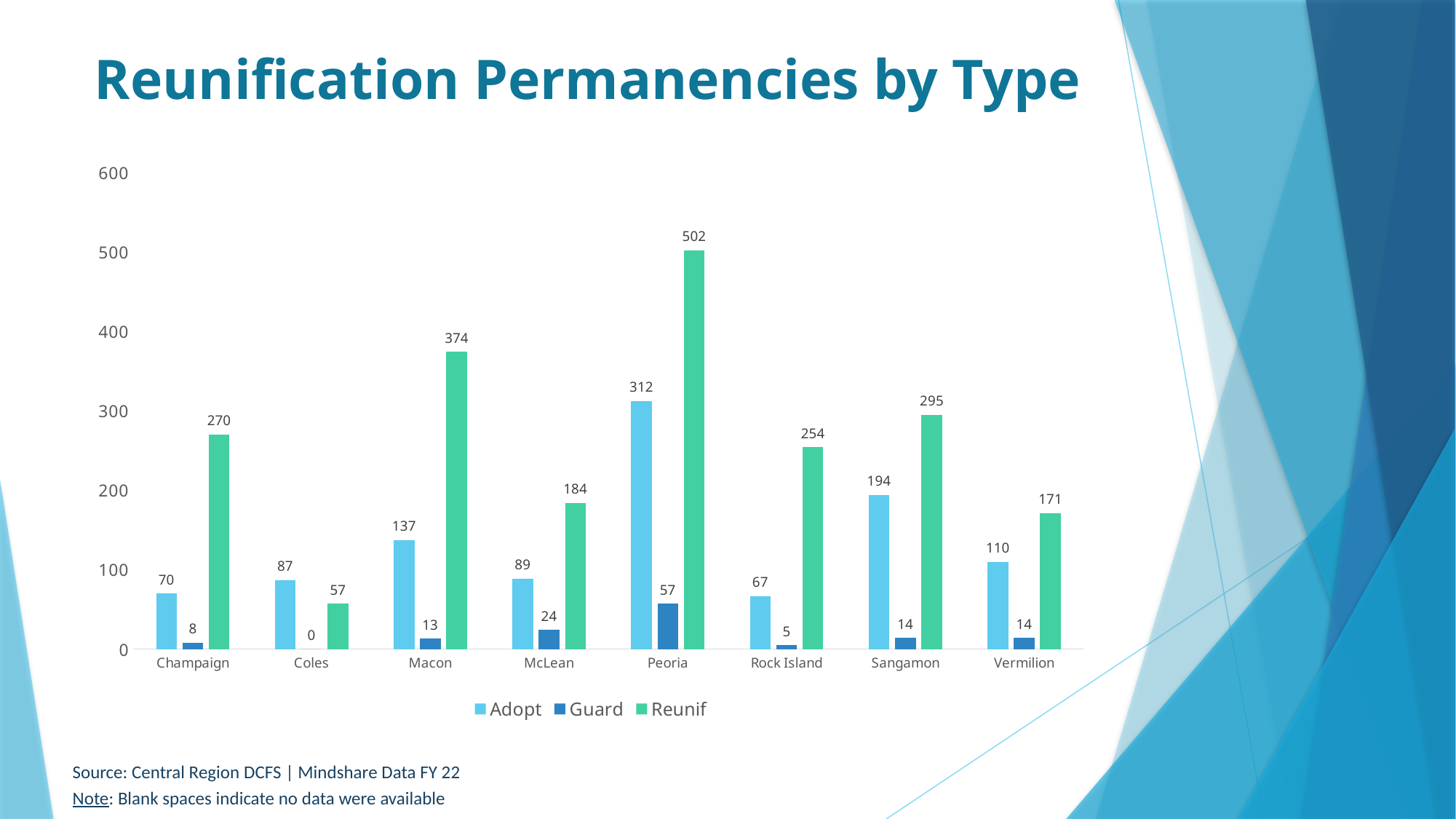
Which county has the highest Reunif value? Peoria What kind of chart is shown on the slide? bar chart How many counties are shown on the x axis? 8 What is the Adopt value for Macon? 137 What is the Reunif value for Peoria? 502 How many series does the legend list? 3 Which is larger, the Adopt value for Sangamon or the Adopt value for Vermilion? Sangamon What is the difference between the Reunif values for Macon and Sangamon? 79 Which county has the lowest Guard value? Coles What is the Guard value for McLean? 24 What is the title of the chart? Reunification Permanencies by Type Is the Reunif value for Rock Island greater or less than 200? greater